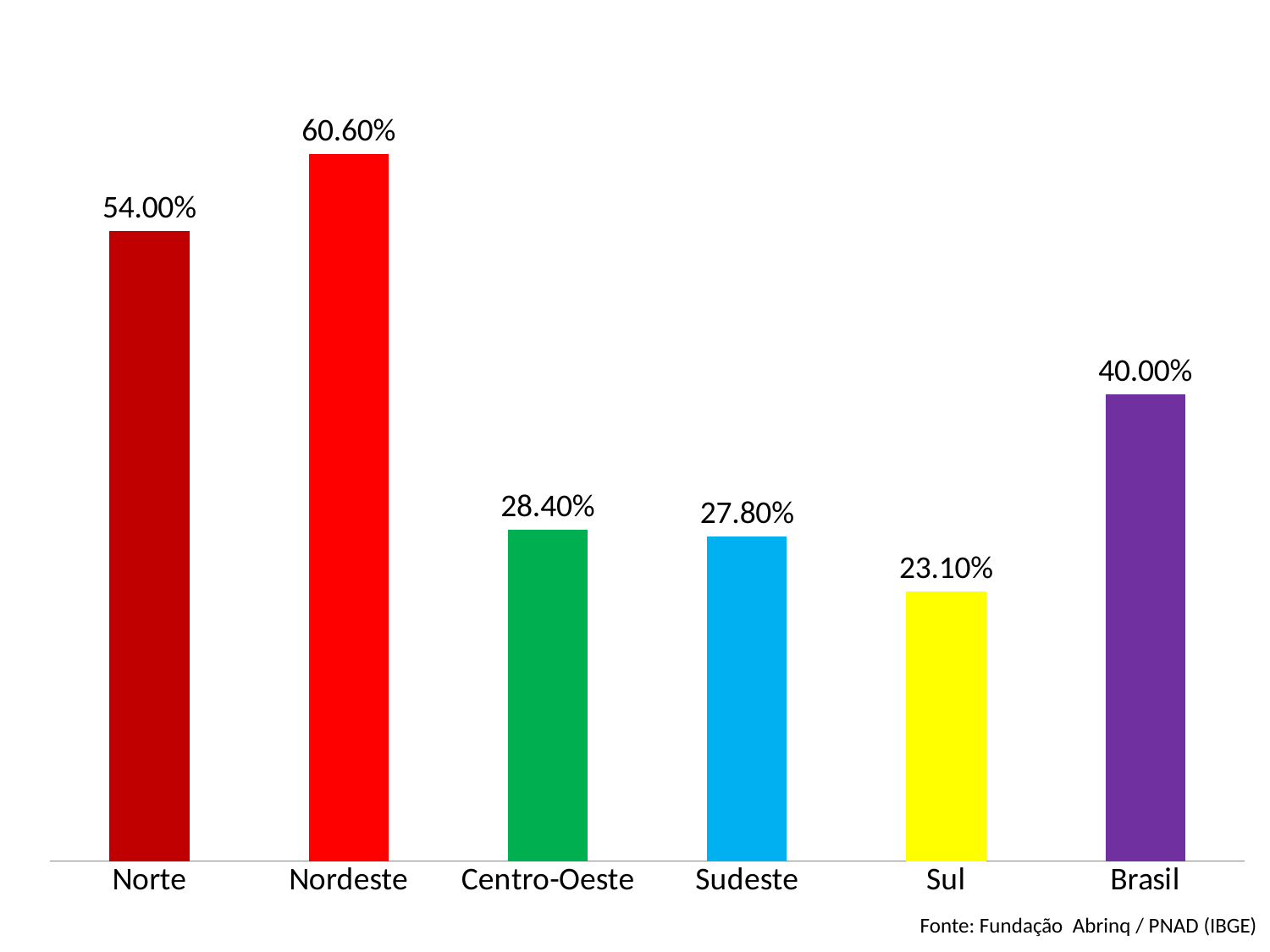
How many categories are shown on the x axis? 6 What is the value for Nordeste? 60.60% Which category has the highest value? Nordeste Which is larger, the value for Norte or the value for Brasil? Norte What is the value for Centro-Oeste? 28.40% What is the difference between the values for Brasil and Sul? 16.90% What colour is the bar for Sudeste? Blue What is the difference between the values for Nordeste and Norte? 6.60% What is the value for Sul? 23.10% Which category has the lowest value? Sul What kind of chart is this? Bar chart What is the value for Brasil? 40.00%